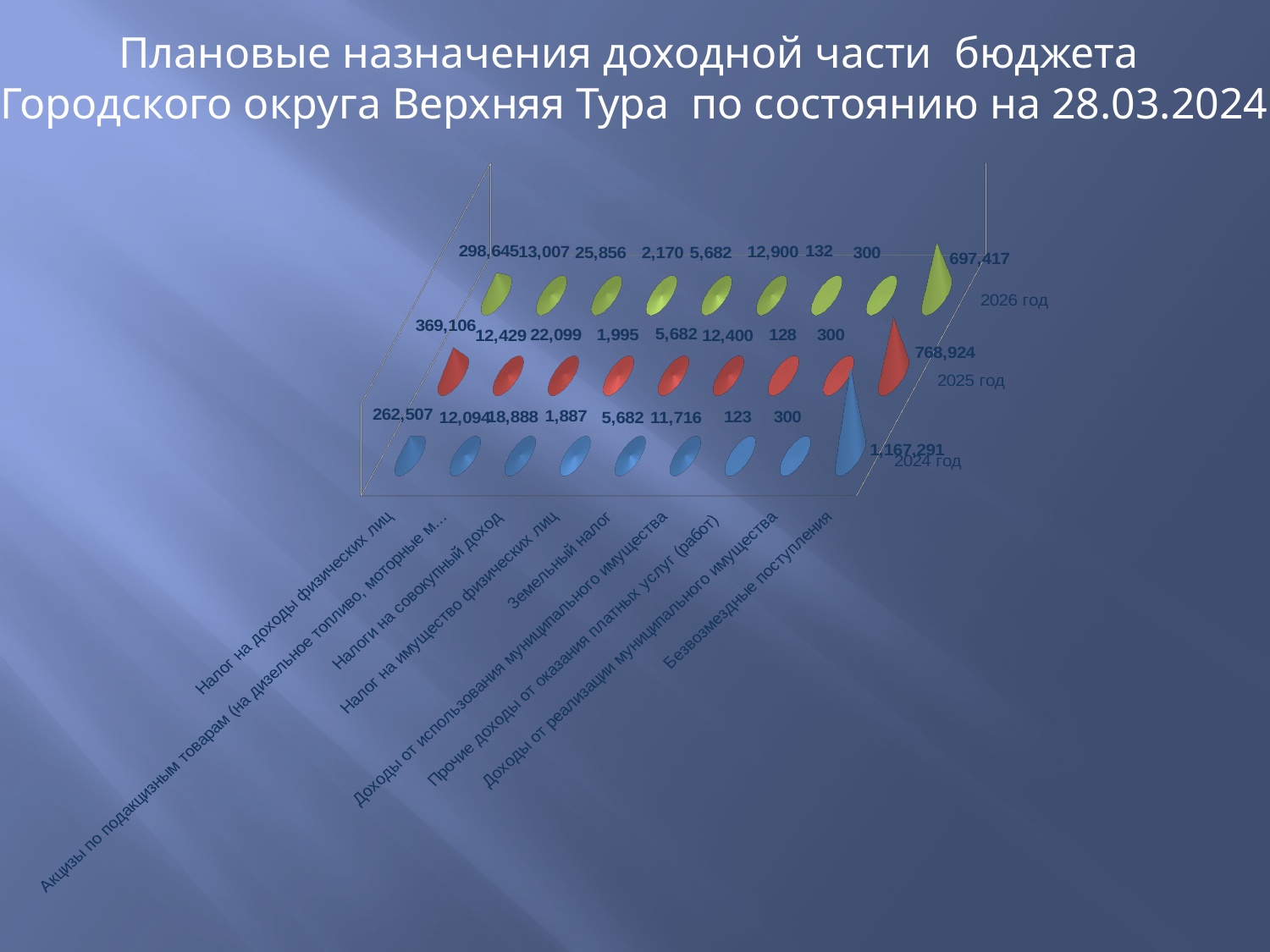
Which colour represents the 2025 год series? red What is the planned value for Безвозмездные поступления in 2024 год? 1,167,291 How many revenue categories are shown on the chart? 9 Which category has the highest value in the 2026 год series? Безвозмездные поступления What is the planned value for Земельный налог in 2024 год? 5,682 Does the value for Налоги на совокупный доход rise or fall from 2024 год to 2026 год? rise How many series (years) does the chart show? 3 Which category has the lowest value in the 2025 год series? Прочие доходы от оказания платных услуг (работ) What is the difference between the 2025 год and 2024 год values for Налог на доходы физических лиц? 106,599 What is the planned value for Налоги на совокупный доход in 2026 год? 25,856 What is the planned value for Налог на доходы физических лиц in 2025 год? 369,106 Which is larger for Безвозмездные поступления: the 2024 год value or the 2026 год value? 2024 год